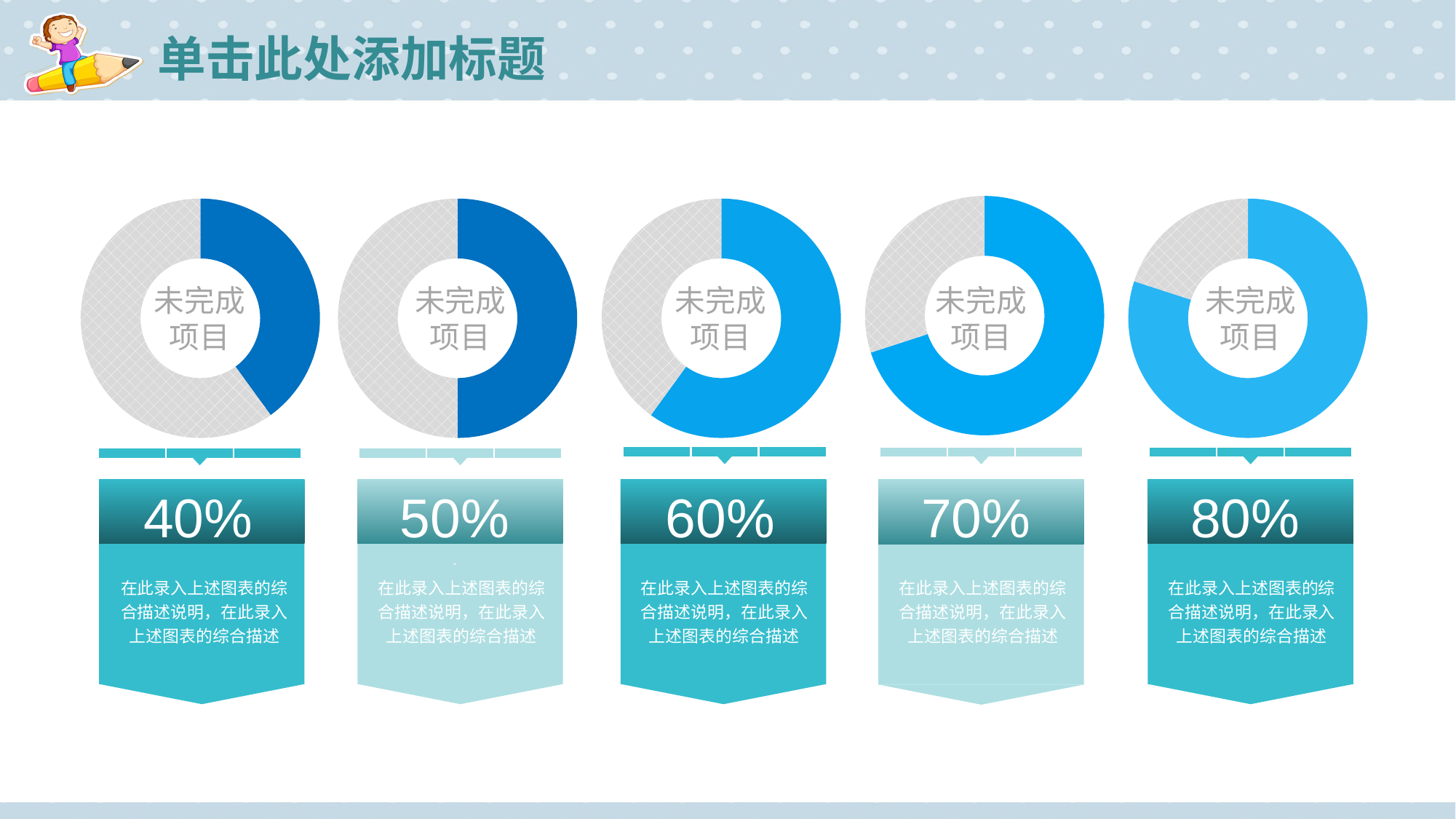
Which is larger, the percentage of the middle chart or the second chart from the left? The middle chart (60%) What percentage is shown below the second donut chart from the left? 50% What is the difference between the percentage of the rightmost chart and the leftmost chart? 40% Do the percentages rise or fall moving from the leftmost chart to the rightmost chart? Rise Which donut chart has the largest blue share, by its position on the slide? The rightmost chart (80%) What percentage is shown below the leftmost donut chart? 40% What kind of chart is used for each of the five figures on the slide? Donut chart What percentage is shown below the rightmost donut chart? 80% Which donut chart has the smallest blue share, by its position on the slide? The leftmost chart (40%) What percentage is shown below the fourth donut chart from the left? 70% What percentage is shown below the middle donut chart? 60% How many donut charts are on the slide? 5